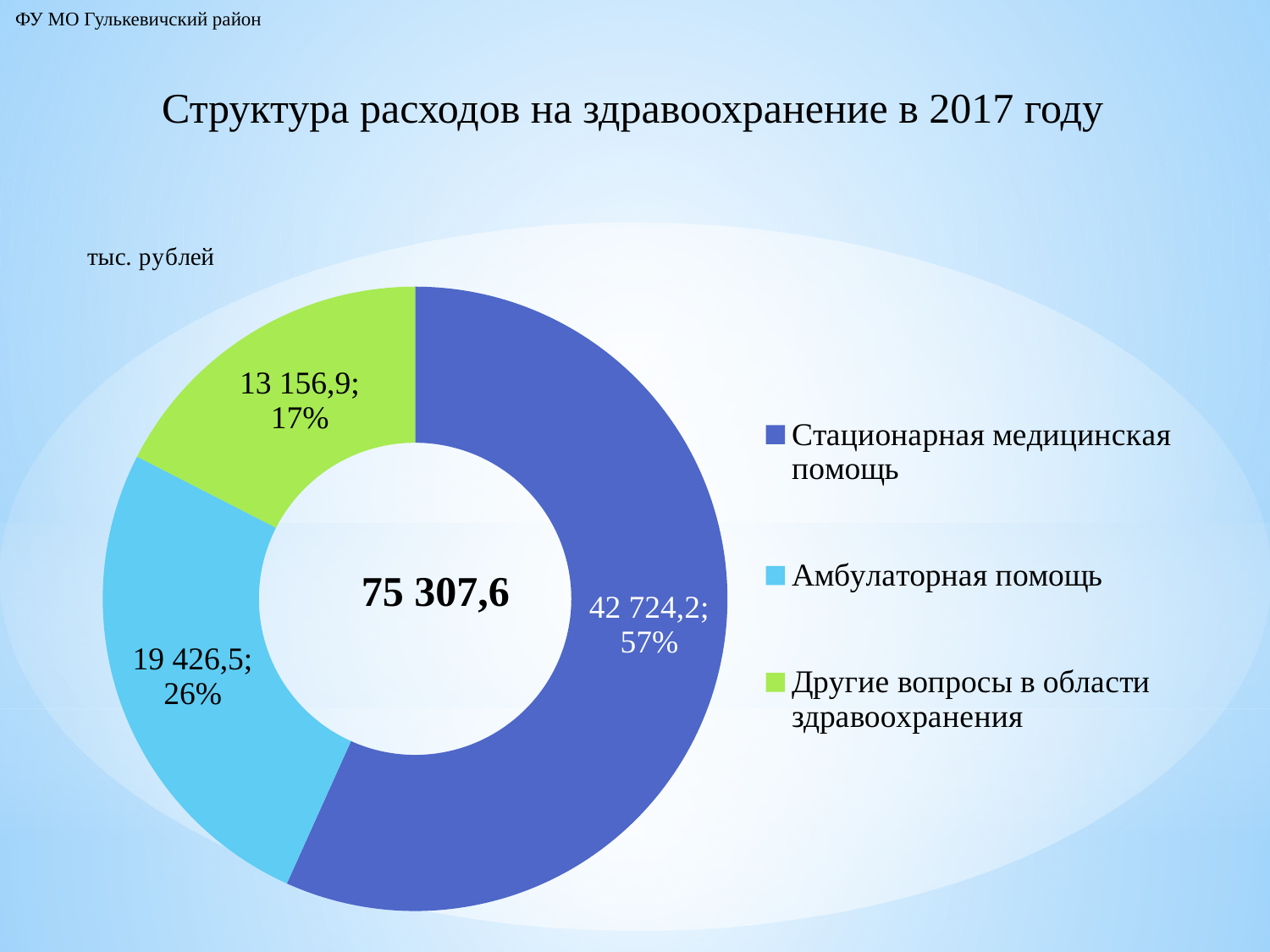
Which category has the smallest value? Другие вопросы в области здравоохранения What share of the total does Другие вопросы в области здравоохранения account for? 17% What total value is shown in the centre of the chart? 75 307,6 What is the value for Стационарная медицинская помощь? 42 724,2 What share of the total does Амбулаторная помощь account for? 26% Which category has the largest value? Стационарная медицинская помощь How many categories does the chart show? 3 What kind of chart is shown on the slide? Pie chart (doughnut) What share of the total does Стационарная медицинская помощь account for? 57% What is the value for Амбулаторная помощь? 19 426,5 What is the value for Другие вопросы в области здравоохранения? 13 156,9 What is the difference between the values for Амбулаторная помощь and Другие вопросы в области здравоохранения? 6 269,6